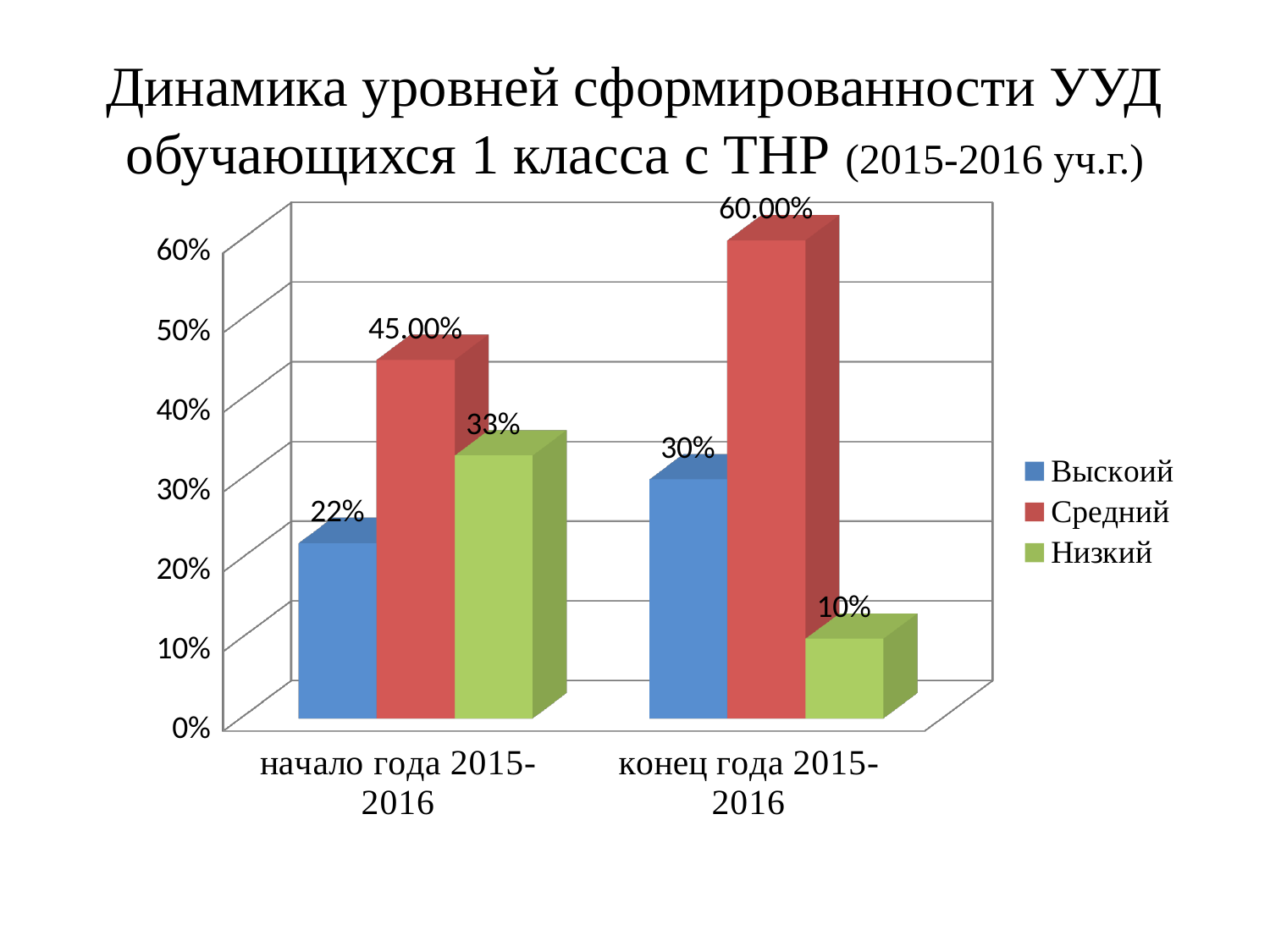
How many categories are shown on the x axis? 2 Which is larger: Низкий at начало года 2015-2016 or Низкий at конец года 2015-2016? начало года 2015-2016 Which series has the highest value at конец года 2015-2016? Средний What is the value for Средний at начало года 2015-2016? 45.00% What is the value for Средний at конец года 2015-2016? 60.00% What is the value for Низкий at конец года 2015-2016? 10% Does the value for Выскоий rise or fall from начало года 2015-2016 to конец года 2015-2016? rise What kind of chart is shown on the slide? bar chart What is the difference between the Средний values at конец года 2015-2016 and начало года 2015-2016? 15% What is the value for Выскоий at начало года 2015-2016? 22% Which series has the lowest value at начало года 2015-2016? Выскоий How many series does the legend list? 3